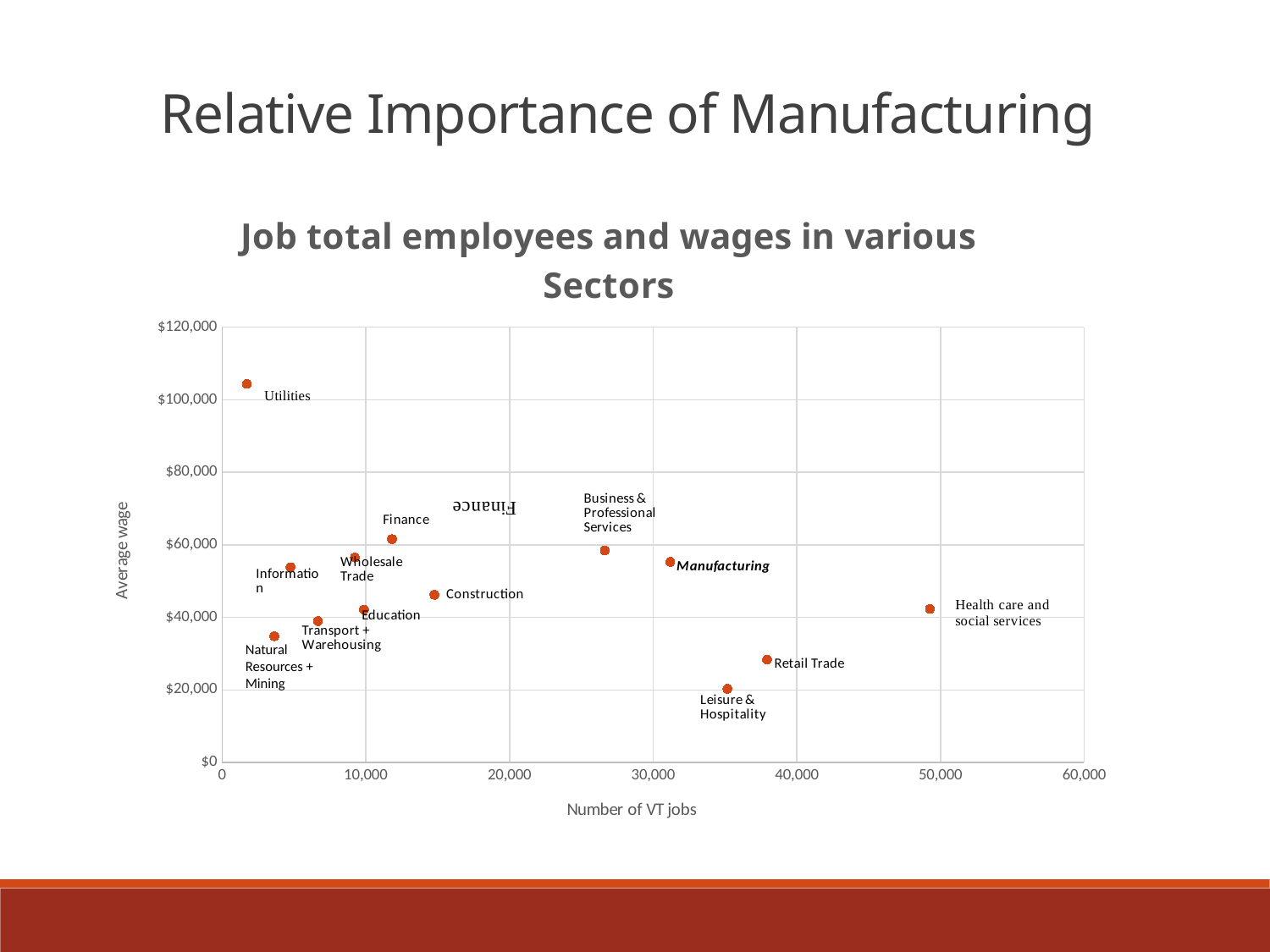
How many sectors are plotted on the chart? 13 Which has a higher average wage, Finance or Construction? Finance What is the title of the x axis? Number of VT jobs Which sector has the lowest average wage? Leisure & Hospitality Is the number of VT jobs for Health care and social services greater or less than 40,000? greater Is the average wage for Retail Trade greater or less than $40,000? less Which sector has the largest number of VT jobs? Health care and social services Is the number of VT jobs for Manufacturing greater or less than 30,000? greater Which has more VT jobs, Retail Trade or Leisure & Hospitality? Retail Trade Which sector has the highest average wage? Utilities What kind of chart is shown on the slide? Scatter chart